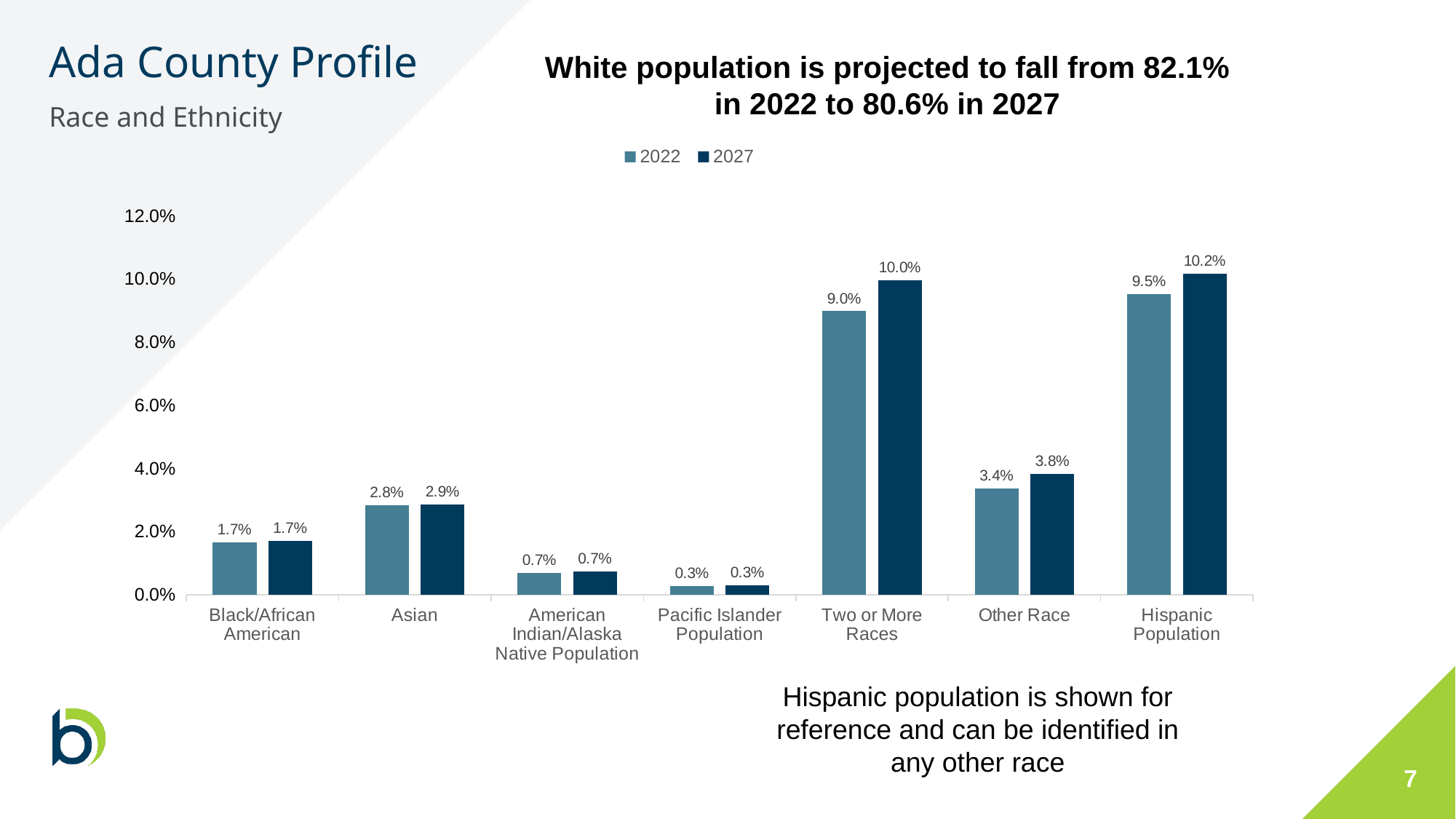
How many categories are shown on the x axis? 7 How many series does the legend list? 2 What is the 2027 value for Other Race? 3.8% What kind of chart is shown on the slide? Bar chart What is the 2027 value for the Hispanic Population? 10.2% Which category has the highest 2027 value? Hispanic Population What is the difference between the 2027 and 2022 values for Two or More Races? 1.0% What is the 2022 value for Two or More Races? 9.0% What is the difference between the 2027 and 2022 values for Other Race? 0.4% Which category has the lowest 2022 value? Pacific Islander Population Which is larger, the 2022 value for Asian or the 2022 value for Other Race? Other Race Is the 2027 value for Two or More Races greater or less than 8.0%? greater